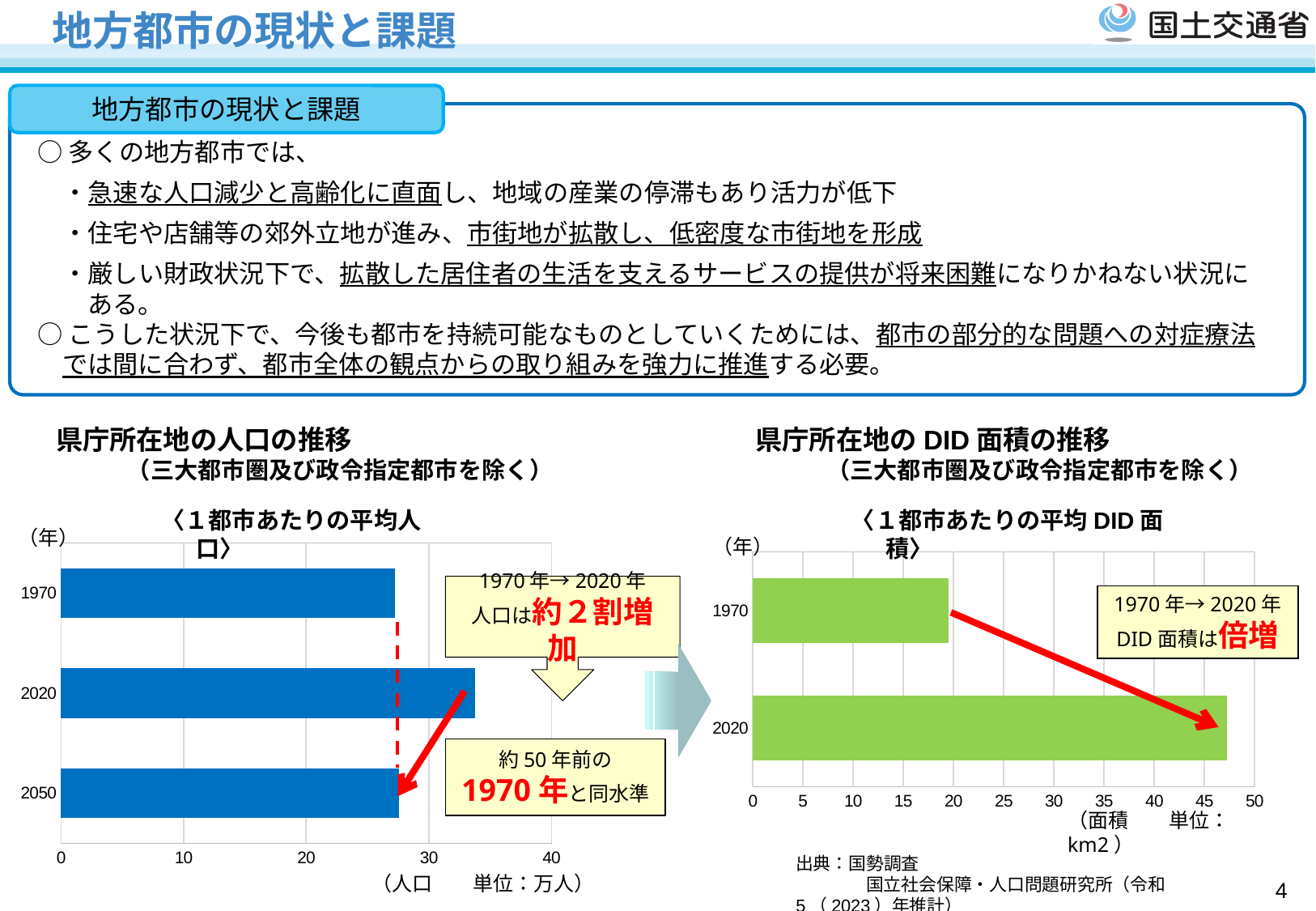
How many years are plotted in the right chart, 県庁所在地のDID面積の推移? 2 What kind of chart is the left chart, 県庁所在地の人口の推移? bar chart In the right chart, 県庁所在地のDID面積の推移, is the value for 2020 greater or less than 45? greater In the right chart, 県庁所在地のDID面積の推移, does the DID area rise or fall from 1970 to 2020? rise In the left chart, 県庁所在地の人口の推移, which is larger, the value for 1970 or the value for 2020? 2020 In the left chart, 県庁所在地の人口の推移, which year has the highest average population? 2020 What unit is shown on the x axis of the right chart, 県庁所在地のDID面積の推移? km2 What kind of chart is the right chart, 県庁所在地のDID面積の推移? bar chart How many years are plotted in the left chart, 県庁所在地の人口の推移? 3 In the left chart, 県庁所在地の人口の推移, is the value for 2050 greater or less than 30? less In the left chart, 県庁所在地の人口の推移, is the value for 2020 greater or less than 30? greater